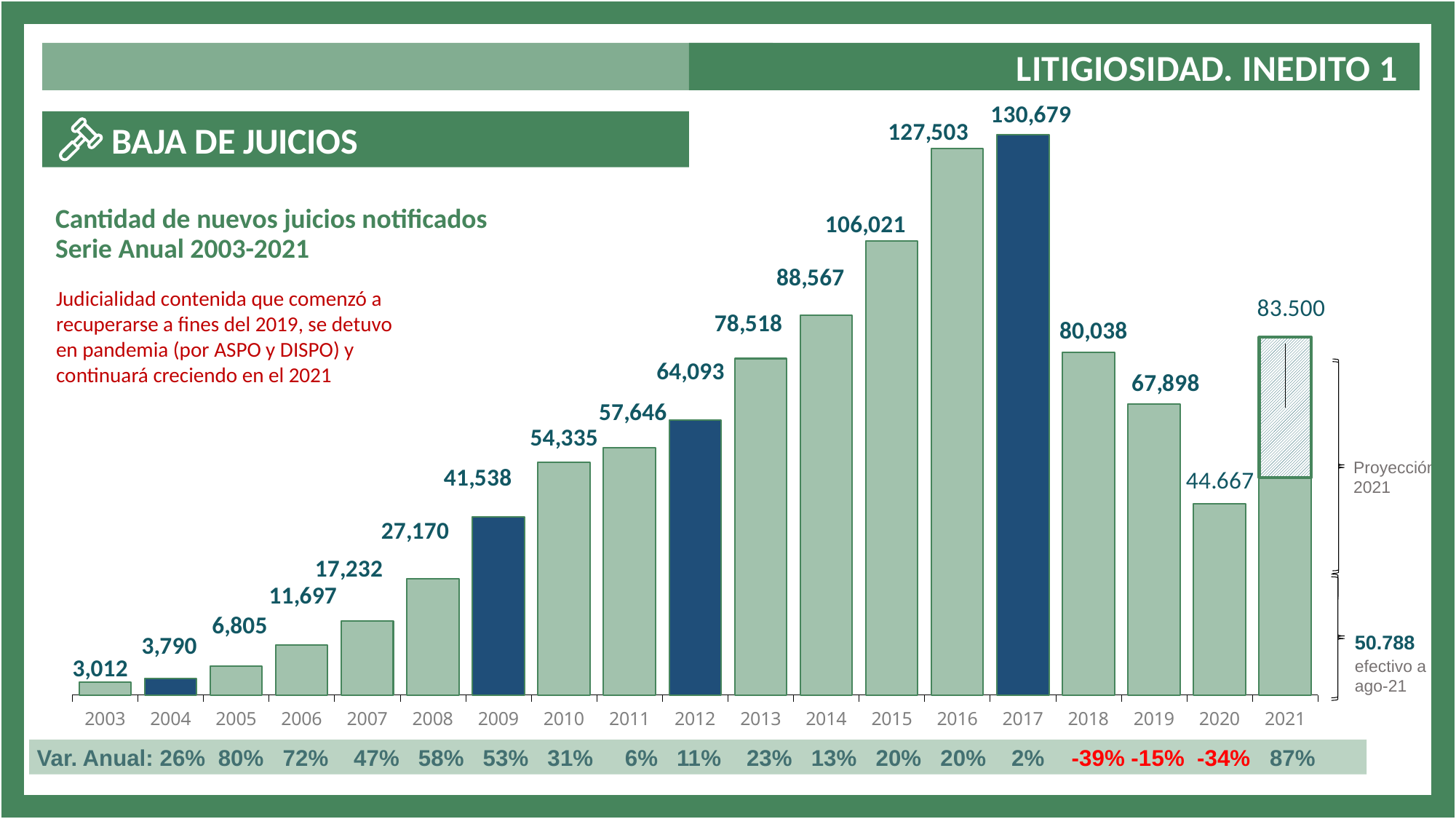
What is the effective value to August 2021 shown next to the 2021 bar? 50.788 How many years are shown on the x axis of the chart? 19 What is the value shown for 2009? 41,538 What kind of chart is shown on the slide? Bar chart Which year has the highest number of new lawsuits notified? 2017 What is the difference between the values for 2017 and 2016? 3,176 Which year has a larger value, 2018 or 2019? 2018 What is the annual variation (Var. Anual) shown for 2018? -39% What is the number of new lawsuits notified in 2017? 130,679 Which year has the lowest number of new lawsuits notified? 2003 Do the values rise or fall from 2003 to 2017? Rise What is the projected value for 2021 shown at the top of the last bar? 83.500